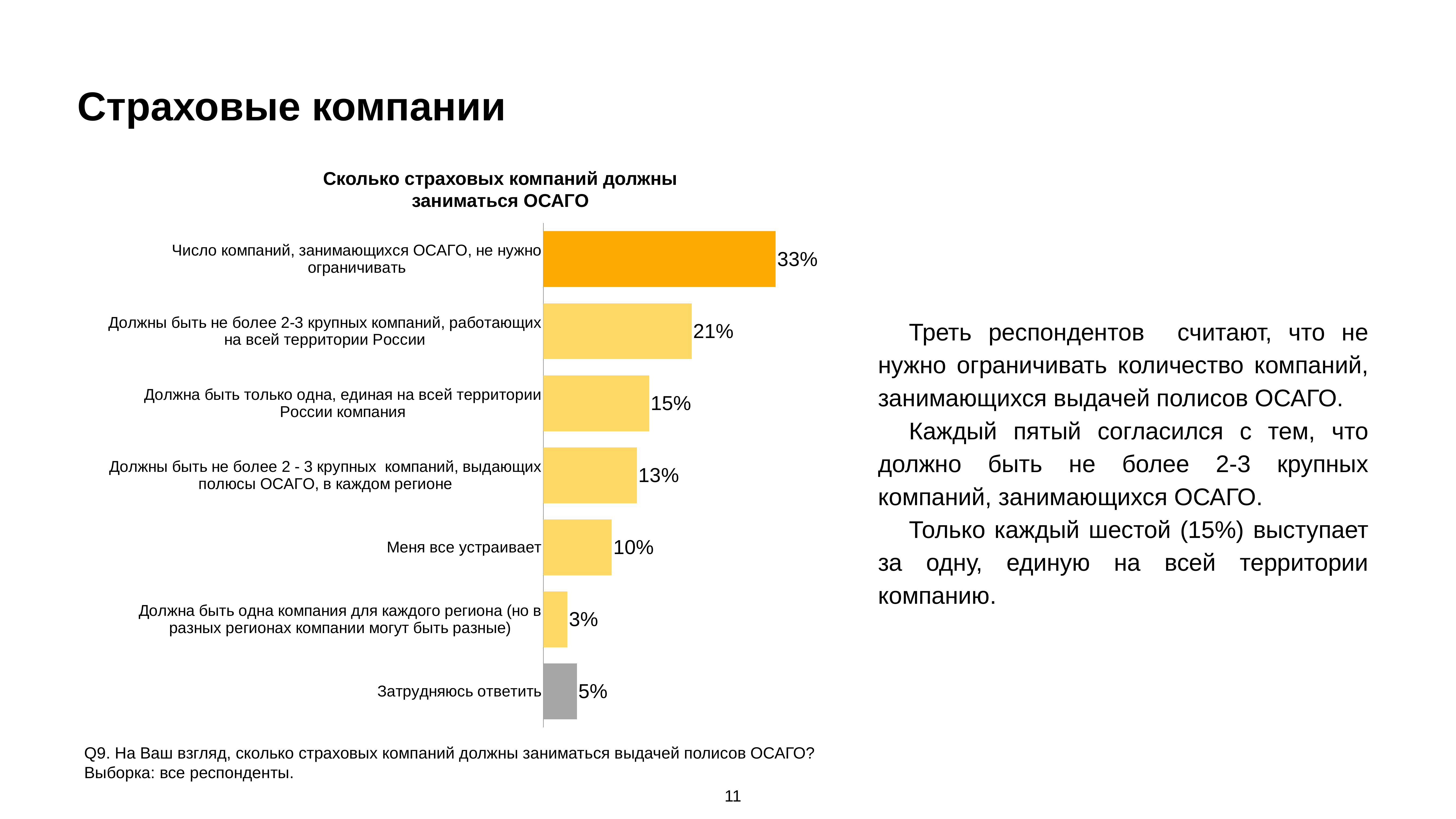
Which category has the highest value? Число компаний, занимающихся ОСАГО, не нужно ограничивать What is the title of the chart? Сколько страховых компаний должны заниматься ОСАГО Which is larger: the value for "Должны быть не более 2 - 3 крупных компаний, выдающих полюсы ОСАГО, в каждом регионе" or for "Меня все устраивает"? Должны быть не более 2 - 3 крупных компаний, выдающих полюсы ОСАГО, в каждом регионе Which category has the lowest value? Должна быть одна компания для каждого региона (но в разных регионах компании могут быть разные) What is the difference between the values for "Число компаний, занимающихся ОСАГО, не нужно ограничивать" and "Должны быть не более 2-3 крупных компаний, работающих на всей территории России"? 12% What is the value for "Должна быть только одна, единая на всей территории России компания"? 15% What is the value for "Меня все устраивает"? 10% What percentage of respondents chose "Число компаний, занимающихся ОСАГО, не нужно ограничивать"? 33% How many categories are shown in the chart? 7 Which bar is coloured grey? Затрудняюсь ответить What is the value for "Затрудняюсь ответить"? 5% What kind of chart is shown on the slide? Bar chart